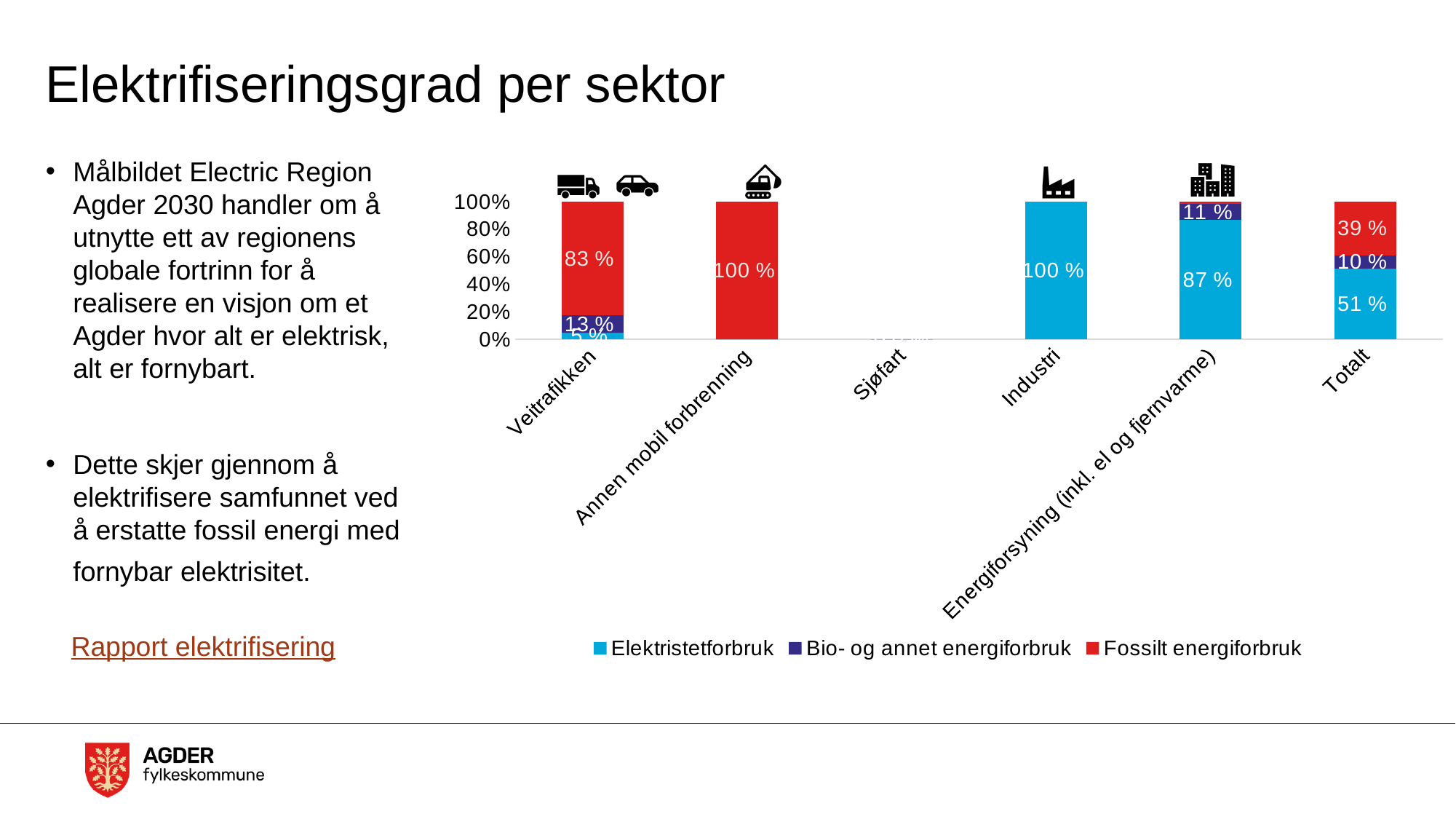
What is the share of Fossilt energiforbruk for Totalt? 39 % What is the difference between the Elektristetforbruk share and the Fossilt energiforbruk share for Totalt? 12 % Which is larger for Totalt: the Elektristetforbruk share or the Bio- og annet energiforbruk share? Elektristetforbruk How many series does the legend list? 3 What kind of chart is shown on the slide? Stacked bar chart What is the share of Elektristetforbruk for Industri? 100 % What is the share of Fossilt energiforbruk for Veitrafikken? 83 % What is the share of Elektristetforbruk for Energiforsyning (inkl. el og fjernvarme)? 87 % What is the share of Fossilt energiforbruk for Annen mobil forbrenning? 100 % Which colour represents Fossilt energiforbruk in the chart? Red What is the share of Bio- og annet energiforbruk for Veitrafikken? 13 % How many sector categories are shown on the x axis? 6